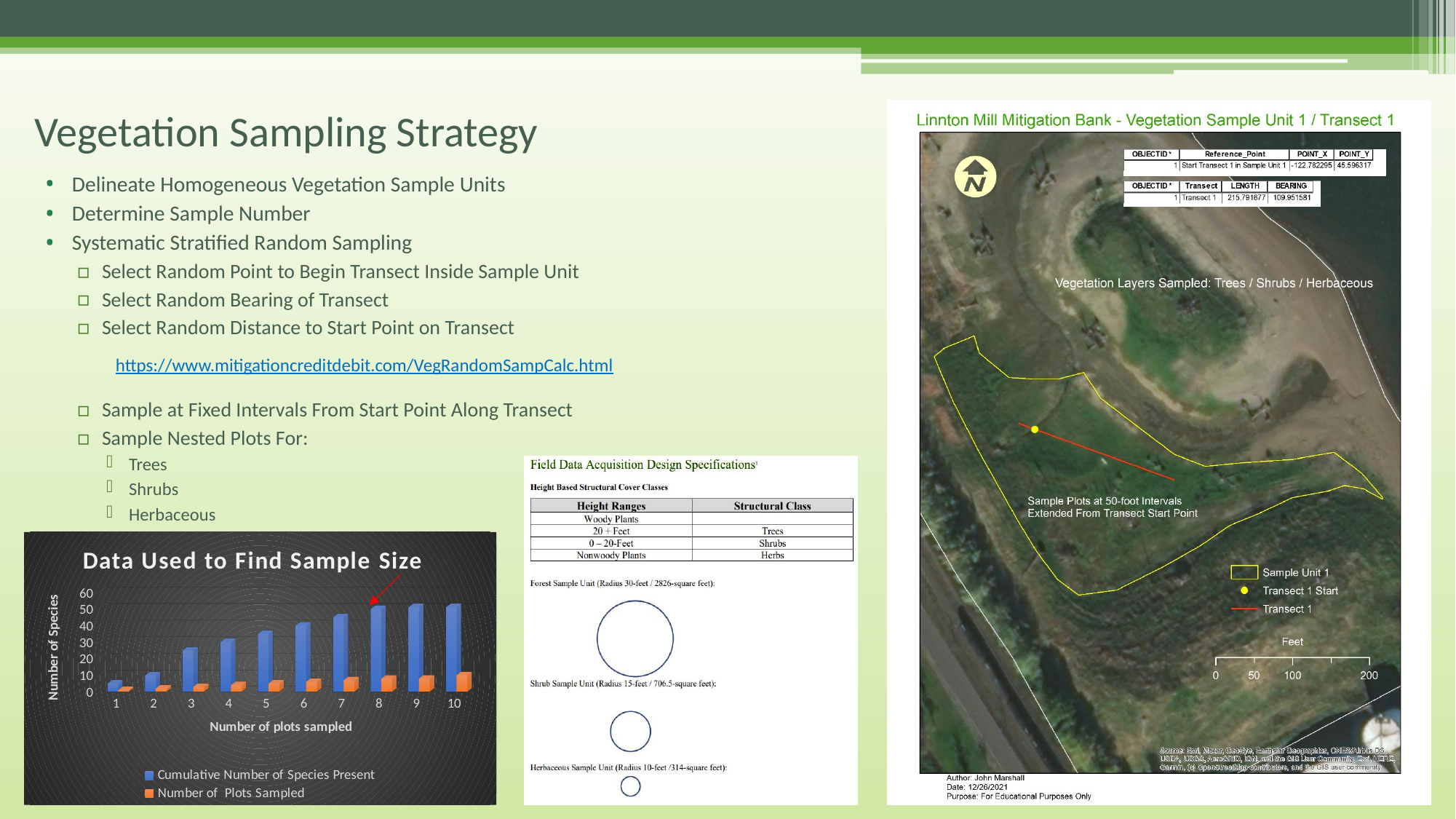
How many categories are shown on the x axis of the "Data Used to Find Sample Size" chart? 10 In the "Data Used to Find Sample Size" chart, at which number of plots sampled is the Cumulative Number of Species Present lowest? 1 In the "Data Used to Find Sample Size" chart, does the Cumulative Number of Species Present rise or fall as the number of plots sampled increases? rise In the "Data Used to Find Sample Size" chart, which series has the taller bars: Cumulative Number of Species Present or Number of Plots Sampled? Cumulative Number of Species Present What kind of chart is "Data Used to Find Sample Size"? bar chart In the "Data Used to Find Sample Size" chart, which is larger: the Cumulative Number of Species Present at 2 plots or at 8 plots? 8 plots What colour represents Number of Plots Sampled in the "Data Used to Find Sample Size" chart? orange In the "Data Used to Find Sample Size" chart, is the Cumulative Number of Species Present at 1 plot greater or less than 10? less In the "Data Used to Find Sample Size" chart, is the Cumulative Number of Species Present at 8 plots greater or less than 40? greater In the "Data Used to Find Sample Size" chart, is the Cumulative Number of Species Present at 3 plots greater or less than 20? greater What is the y-axis label of the "Data Used to Find Sample Size" chart? Number of Species How many series does the legend of the "Data Used to Find Sample Size" chart list? 2